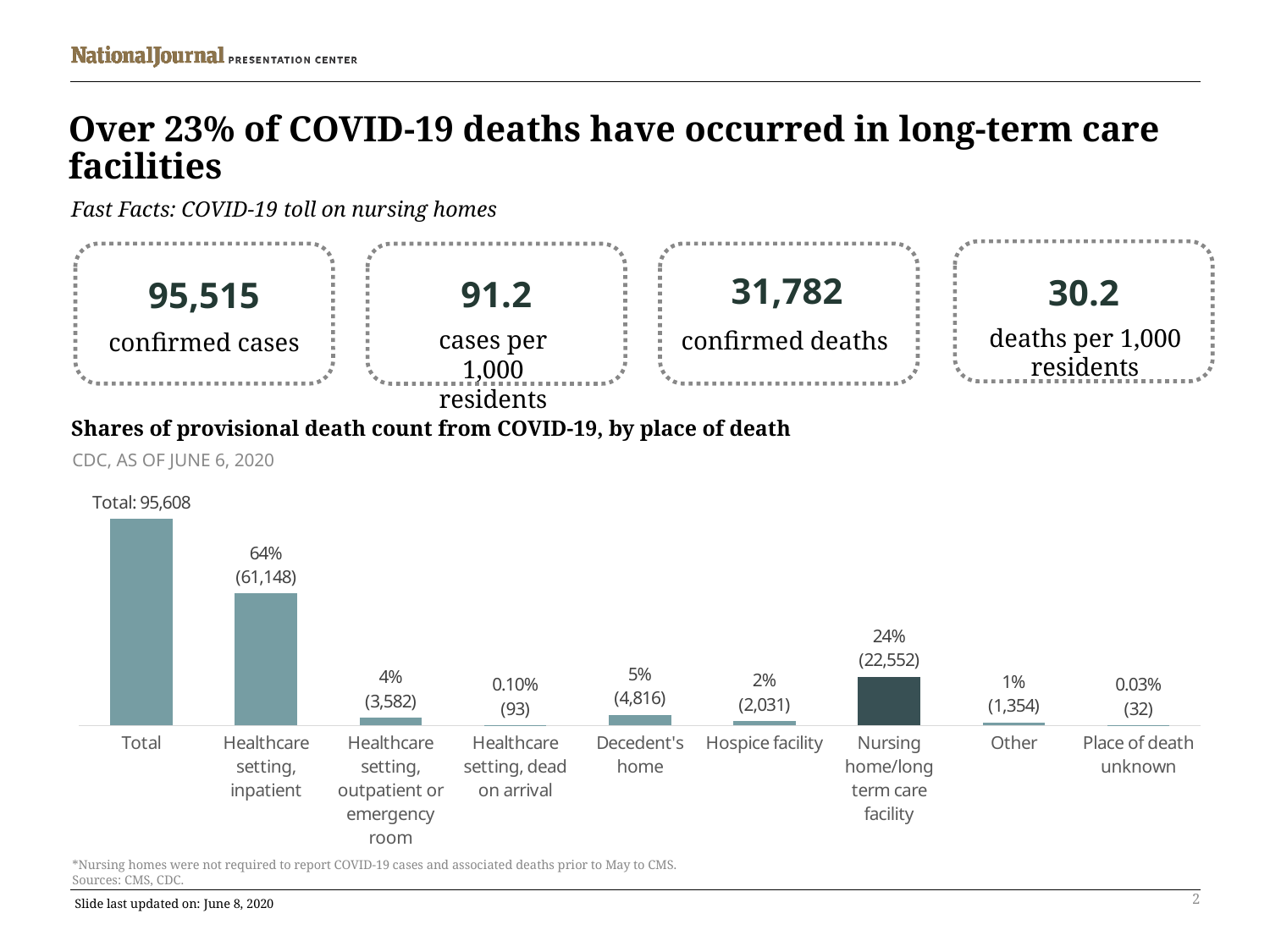
Excluding the Total bar, which place of death has the highest share of deaths? Healthcare setting, inpatient What is the total death count shown on the chart? 95,608 What is the death count for 'Place of death unknown'? 32 Which has more deaths: hospice facility or decedent's home? Decedent's home Which place of death has the lowest share of deaths? Place of death unknown What share of deaths occurred at the decedent's home? 5% What share of COVID-19 deaths occurred in a healthcare setting, inpatient? 64% How many bars are shown on the chart, including the Total bar? 9 How many deaths are shown for the nursing home/long term care facility bar? 22,552 What kind of chart is shown under the heading 'Shares of provisional death count from COVID-19, by place of death'? Bar chart What is the date given for the CDC data in the chart subtitle? June 6, 2020 What is the difference in death counts between healthcare setting, inpatient and nursing home/long term care facility? 38,596